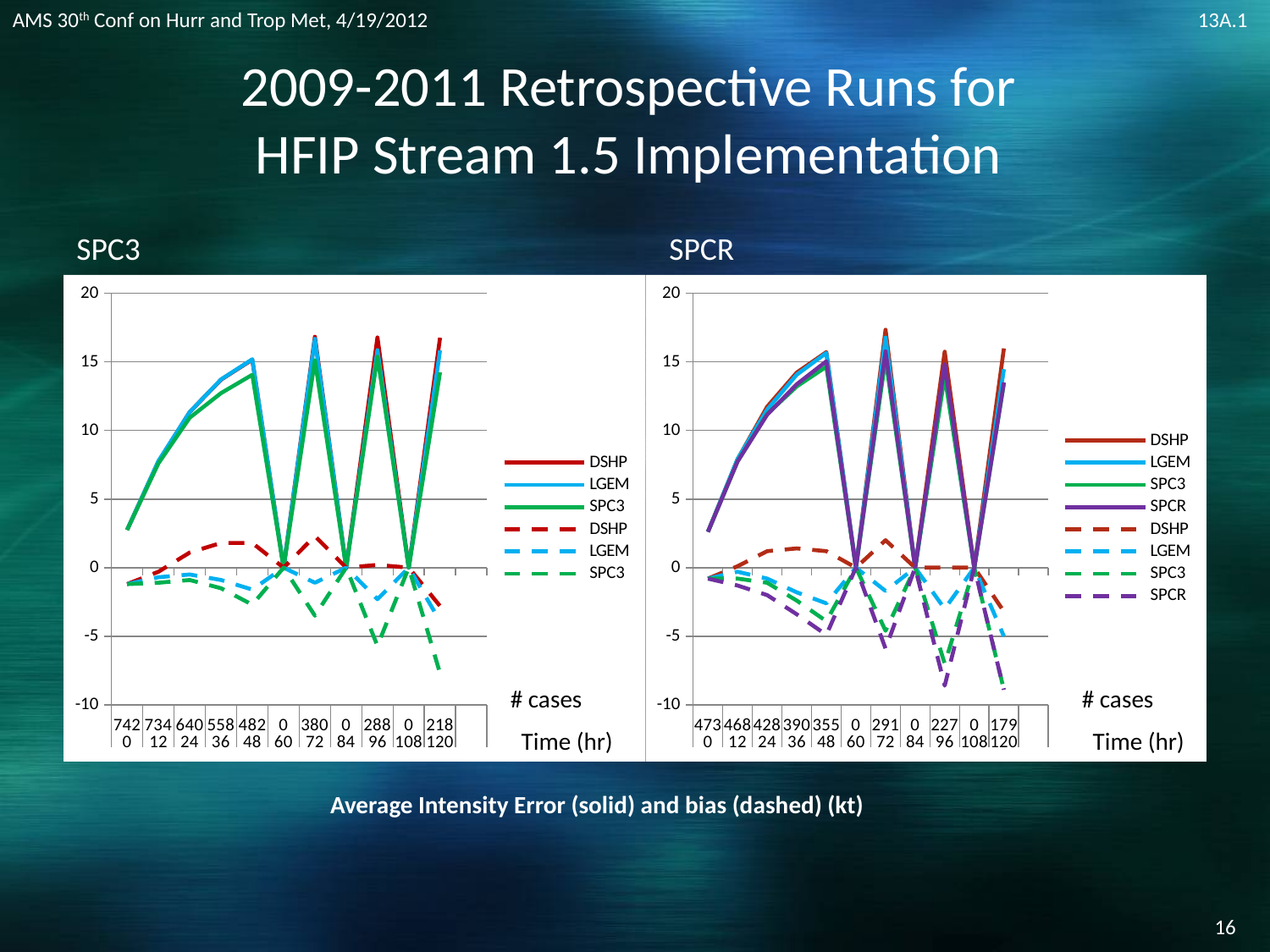
In the SPC3 chart on the left, how many cases are listed for time 0 hr? 742 What is the label of the y-axis quantity described in the caption below the charts? Average Intensity Error (solid) and bias (dashed) (kt) In the SPC3 chart on the left, is the solid LGEM value at 0 hr greater or less than 5? less In the SPCR chart on the right, is the dashed SPCR value at 96 hr greater or less than -5? less What kind of chart is the SPC3 chart on the left? line chart In the SPCR chart on the right, how many cases are listed for time 120 hr? 179 How many entries does the legend of the SPCR chart on the right list? 8 How many entries does the legend of the SPC3 chart on the left list? 6 How many time points are shown along the x axis of the SPC3 chart on the left? 11 In the SPCR chart on the right, at which time (hr) is the number of cases highest? 0 In the SPC3 chart on the left, what is the difference in number of cases between 0 hr and 120 hr? 524 In the SPC3 chart on the left, is the solid SPC3 value at 48 hr greater or less than 10? greater